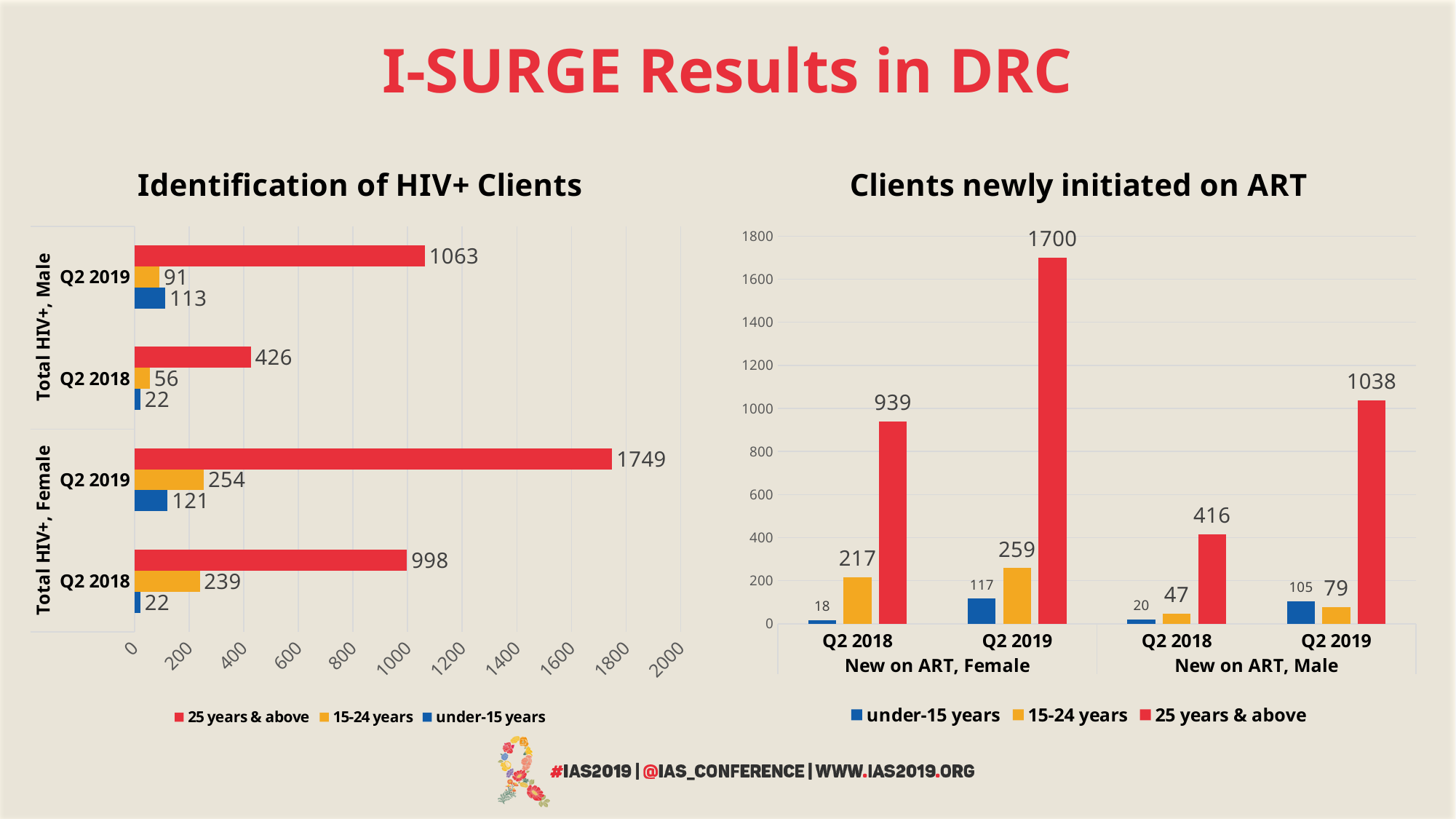
In the 'Clients newly initiated on ART' chart, what is the value for 25 years & above for New on ART, Female in Q2 2019? 1700 In the 'Clients newly initiated on ART' chart, what is the difference between the 25 years & above values for New on ART, Male in Q2 2019 and Q2 2018? 622 In the 'Identification of HIV+ Clients' chart, what is the difference between the 25 years & above values for Total HIV+, Male in Q2 2019 and Q2 2018? 637 In the 'Identification of HIV+ Clients' chart, what is the value for 25 years & above for Total HIV+, Female in Q2 2019? 1749 In the 'Identification of HIV+ Clients' chart, how many series does the legend list? 3 In the 'Clients newly initiated on ART' chart, what is the value for under-15 years for New on ART, Male in Q2 2018? 20 In the 'Identification of HIV+ Clients' chart, which is larger: the 15-24 years value for Total HIV+, Female in Q2 2018 or in Q2 2019? Q2 2019 In the 'Clients newly initiated on ART' chart, which colour represents the 15-24 years series? Orange In the 'Clients newly initiated on ART' chart, does the 25 years & above value for New on ART, Female rise or fall from Q2 2018 to Q2 2019? Rise What kind of chart is 'Identification of HIV+ Clients'? Bar chart In the 'Clients newly initiated on ART' chart, which category has the highest 25 years & above value? New on ART, Female, Q2 2019 In the 'Identification of HIV+ Clients' chart, what is the value for under-15 years for Total HIV+, Male in Q2 2019? 113